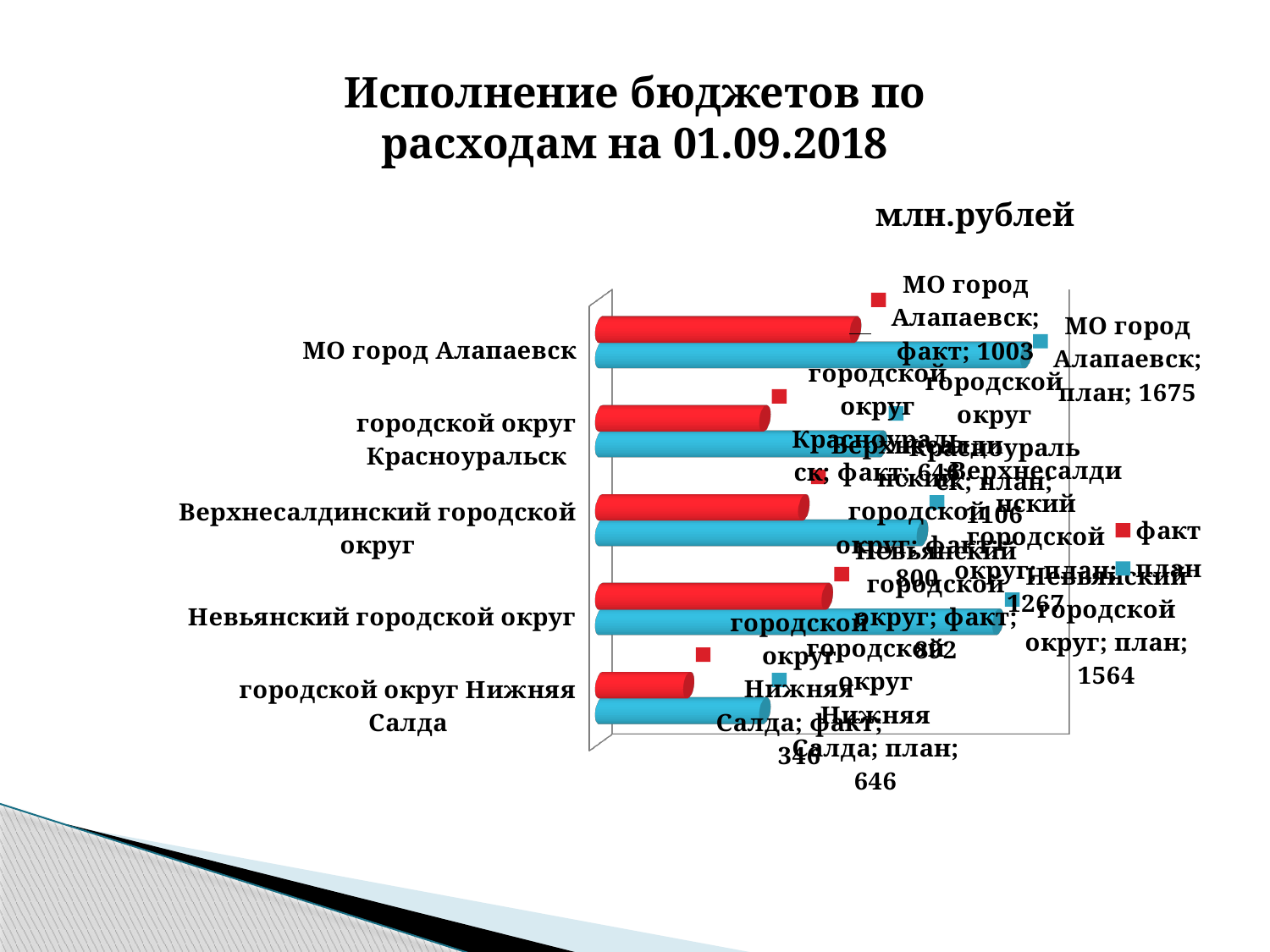
What is the факт value for МО город Алапаевск? 1003 What kind of chart is shown on the slide? bar chart What is the план value for городской округ Нижняя Салда? 646 What is the план value for Невьянский городской округ? 1564 What is the difference between план and факт for городской округ Нижняя Салда? 300 Which municipality has the lowest план value? городской округ Нижняя Салда What is the difference between план and факт for МО город Алапаевск? 672 What is the план value for МО город Алапаевск? 1675 How many series does the legend list? 2 How many municipalities (categories) are shown on the chart? 5 What is the факт value for городской округ Нижняя Салда? 346 Which colour represents the факт series in the legend? red